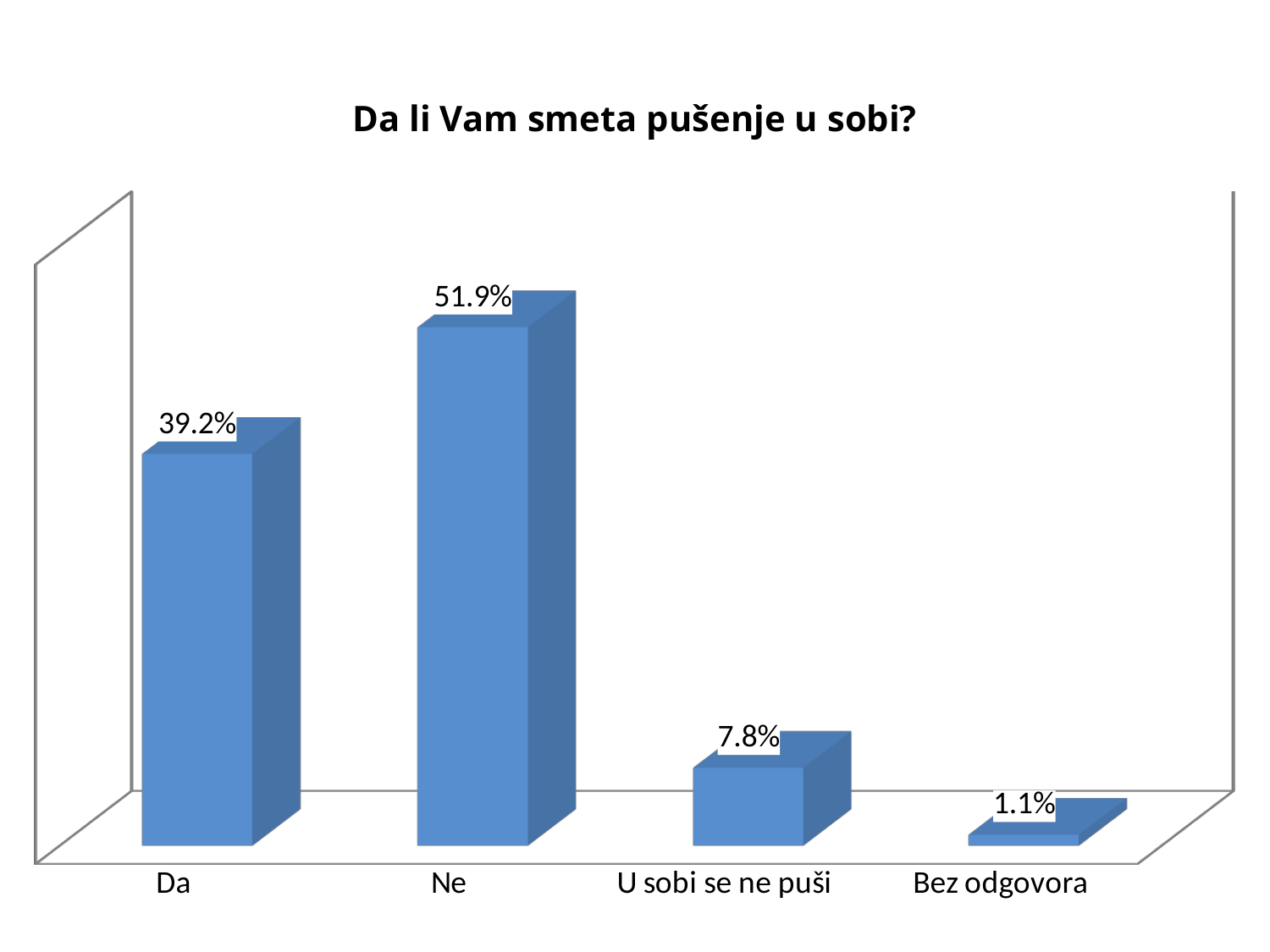
What kind of chart is shown on the slide? Bar chart What is the value for "Bez odgovora"? 1.1% Which category has the lowest value? Bez odgovora What is the difference between the values for "U sobi se ne puši" and "Bez odgovora"? 6.7% What is the title of the chart? Da li Vam smeta pušenje u sobi? How many categories are shown on the chart? 4 What is the difference between the values for "Ne" and "Da"? 12.7% What is the value for "Da"? 39.2% What is the value for "Ne"? 51.9% Which category has the highest value? Ne Which is larger, the value for "Da" or the value for "U sobi se ne puši"? Da What is the value for "U sobi se ne puši"? 7.8%